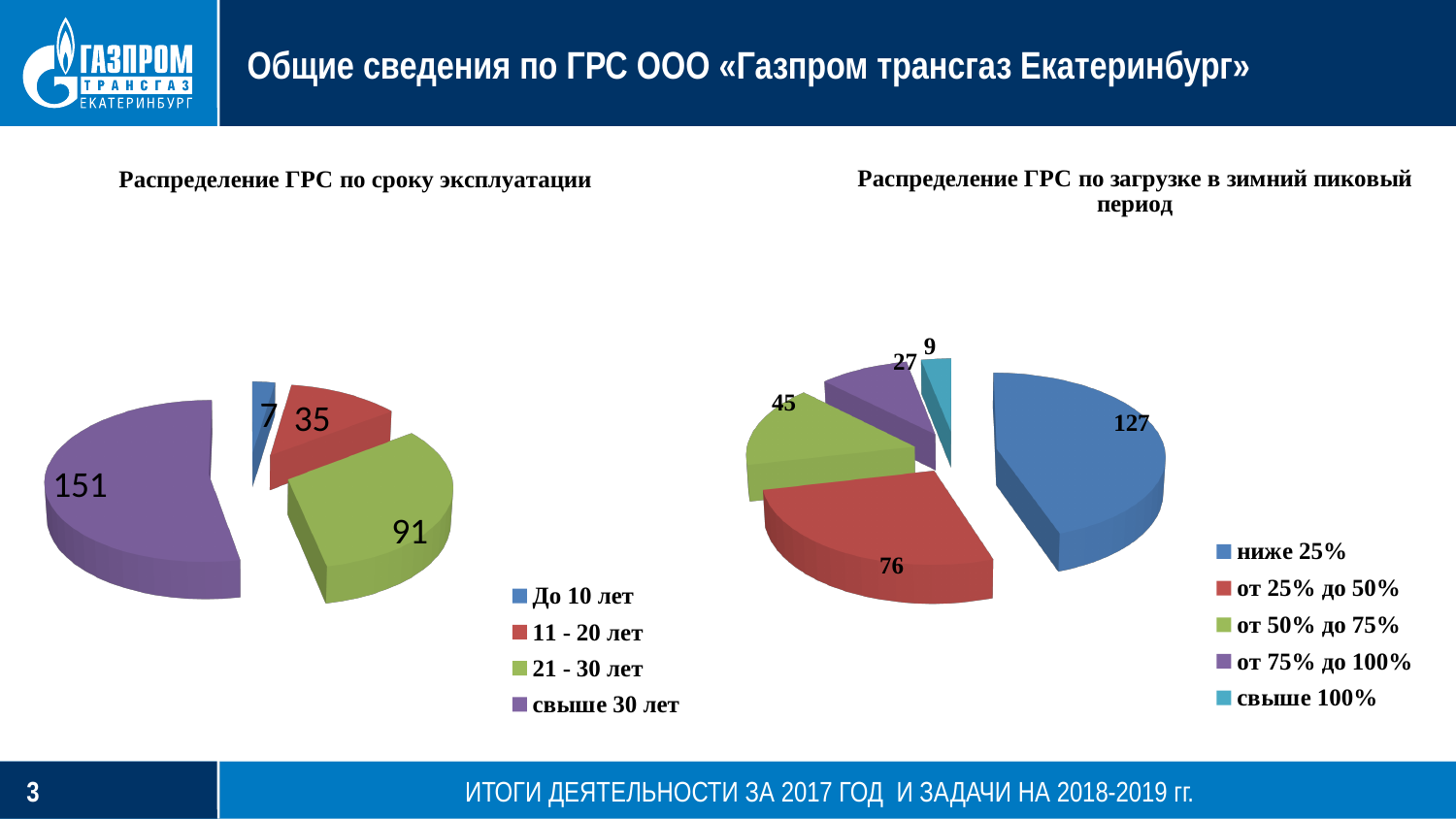
What type of chart is 'Распределение ГРС по сроку эксплуатации'? Pie chart In the chart 'Распределение ГРС по сроку эксплуатации', what is the difference between the values for '21 - 30 лет' and '11 - 20 лет'? 56 In the chart 'Распределение ГРС по загрузке в зимний пиковый период', which is larger: 'от 25% до 50%' or 'от 50% до 75%'? от 25% до 50% In the chart 'Распределение ГРС по загрузке в зимний пиковый период', which category has the largest value? ниже 25% In the chart 'Распределение ГРС по загрузке в зимний пиковый период', what is the value for 'ниже 25%'? 127 In the chart 'Распределение ГРС по загрузке в зимний пиковый период', how many slices does the pie have? 5 In the chart 'Распределение ГРС по загрузке в зимний пиковый период', what is the value for 'от 75% до 100%'? 27 In the chart 'Распределение ГРС по сроку эксплуатации', which category has the smallest value? До 10 лет In the chart 'Распределение ГРС по сроку эксплуатации', what is the value for '11 - 20 лет'? 35 In the chart 'Распределение ГРС по сроку эксплуатации', what is the value for 'свыше 30 лет'? 151 In the chart 'Распределение ГРС по сроку эксплуатации', how many categories does the legend list? 4 In the chart 'Распределение ГРС по загрузке в зимний пиковый период', what is the difference between the values for 'ниже 25%' and 'от 25% до 50%'? 51